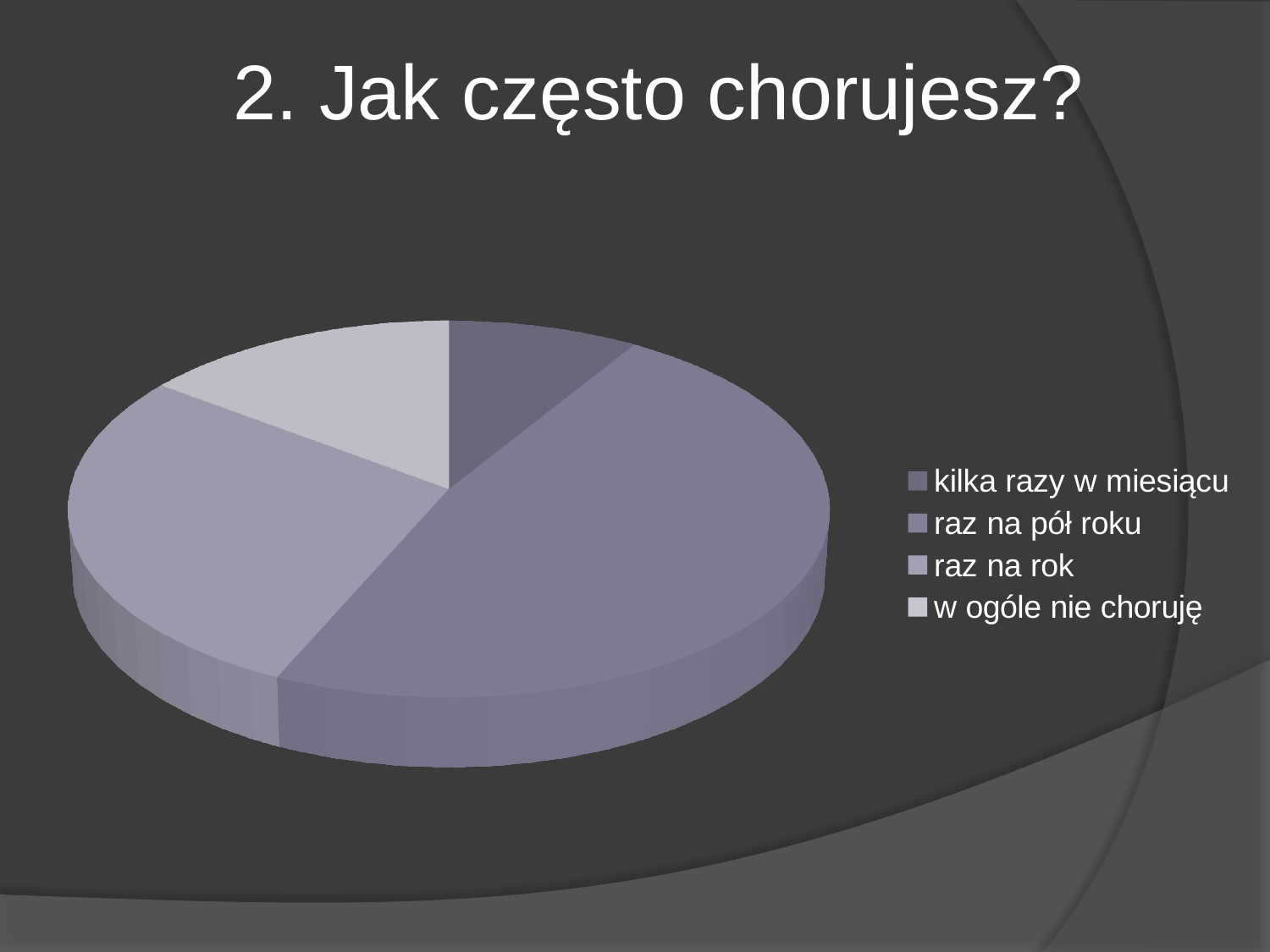
Which slice is larger: 'raz na pół roku' or 'raz na rok'? raz na pół roku What is the title of the slide with the pie chart? 2. Jak często chorujesz? Which category has the smallest slice in the pie chart? kilka razy w miesiącu What kind of chart is shown on the slide? pie chart How many entries does the legend of the pie chart list? 4 How many slices does the pie chart have? 4 Which legend entry is listed last in the pie chart's legend? w ogóle nie choruję Which slice is larger: 'raz na pół roku' or 'kilka razy w miesiącu'? raz na pół roku Which category has the largest slice in the pie chart? raz na pół roku Which slice is larger: 'raz na rok' or 'w ogóle nie choruję'? raz na rok